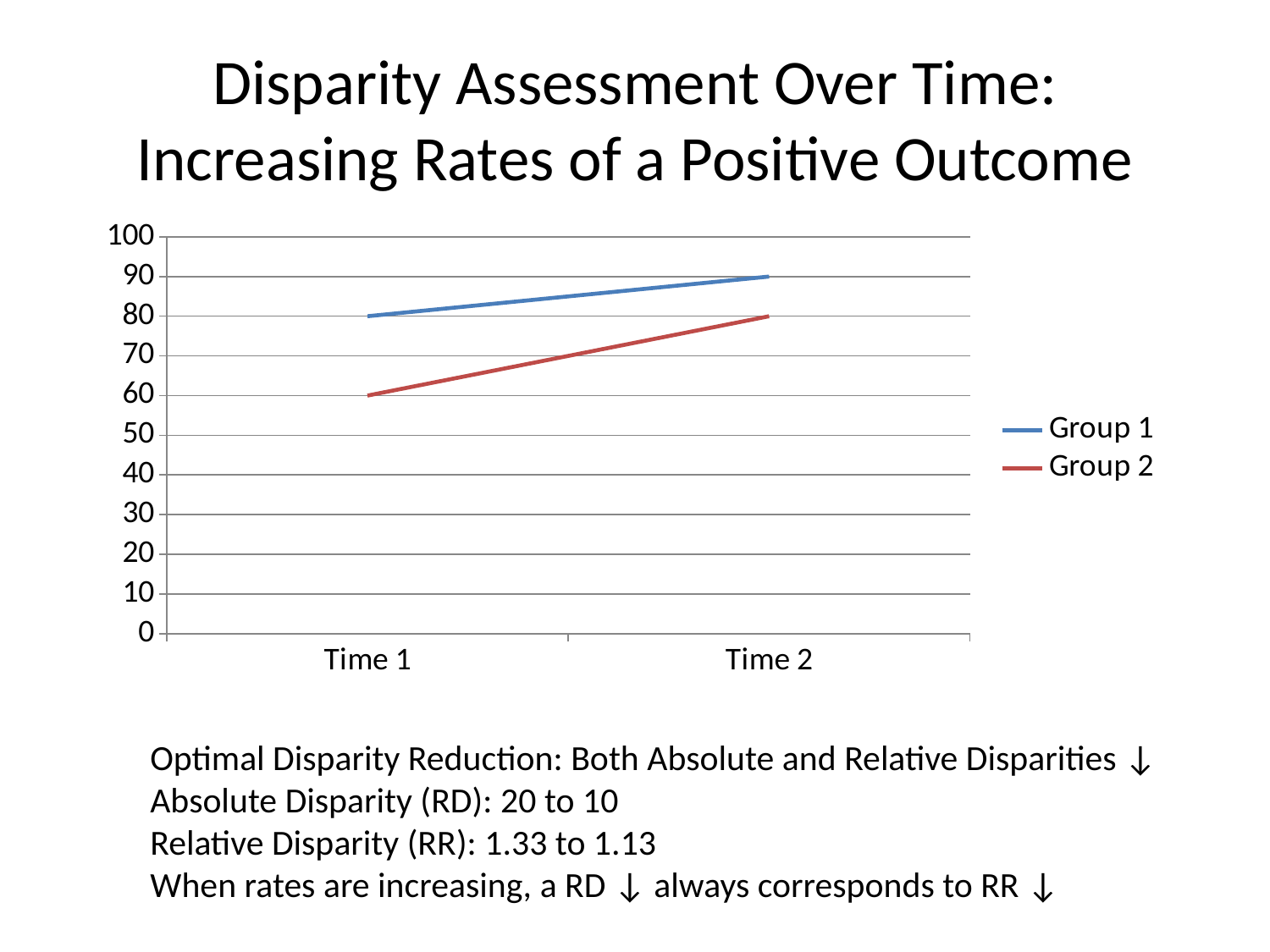
How many series does the legend list? 2 Does the value for Group 2 rise or fall from Time 1 to Time 2? rise Is the value for Group 2 at Time 1 greater or less than 70? less What is the value for Group 2 at Time 2? 80 Which group has the higher value at Time 1? Group 1 What is the value for Group 2 at Time 1? 60 What colour is the line for Group 2? red What is the value for Group 1 at Time 2? 90 What is the difference between Group 1 and Group 2 at Time 2? 10 What is the value for Group 1 at Time 1? 80 How many time points are plotted on the x axis? 2 What kind of chart is shown on the slide? line chart